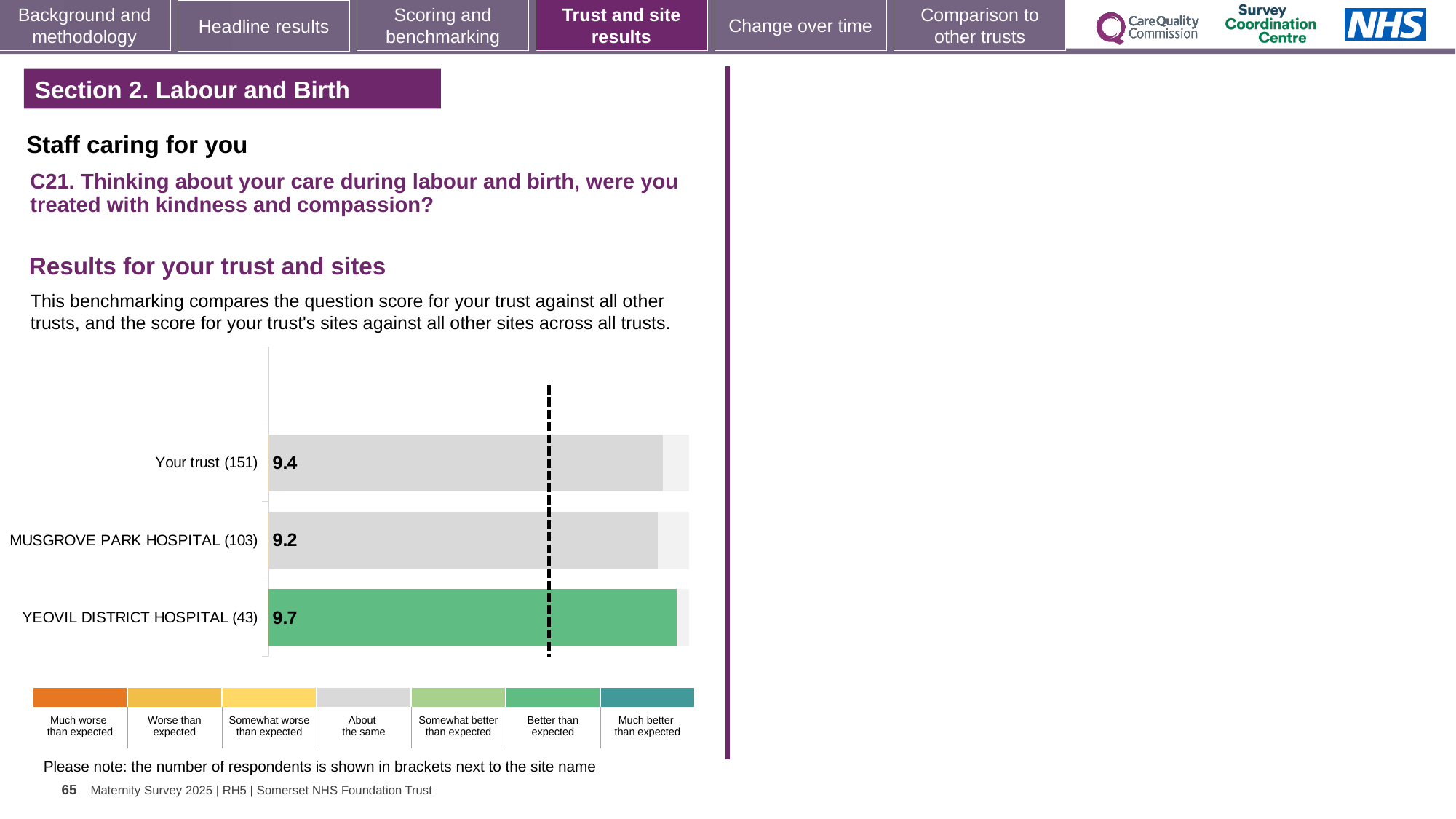
How many respondents are shown in brackets for YEOVIL DISTRICT HOSPITAL? 43 What is the score for Your trust (151)? 9.4 How many bars are shown in the chart? 3 Which category has the highest score? YEOVIL DISTRICT HOSPITAL (43) What is the difference between the scores for YEOVIL DISTRICT HOSPITAL (43) and MUSGROVE PARK HOSPITAL (103)? 0.5 Which bar in the chart is coloured green rather than grey? YEOVIL DISTRICT HOSPITAL (43) What kind of chart is shown on the slide? Bar chart Which category has the lowest score? MUSGROVE PARK HOSPITAL (103) What is the score for MUSGROVE PARK HOSPITAL (103)? 9.2 Which has a higher score, Your trust (151) or YEOVIL DISTRICT HOSPITAL (43)? YEOVIL DISTRICT HOSPITAL (43) What is the score for YEOVIL DISTRICT HOSPITAL (43)? 9.7 What is the difference between the scores for Your trust (151) and MUSGROVE PARK HOSPITAL (103)? 0.2